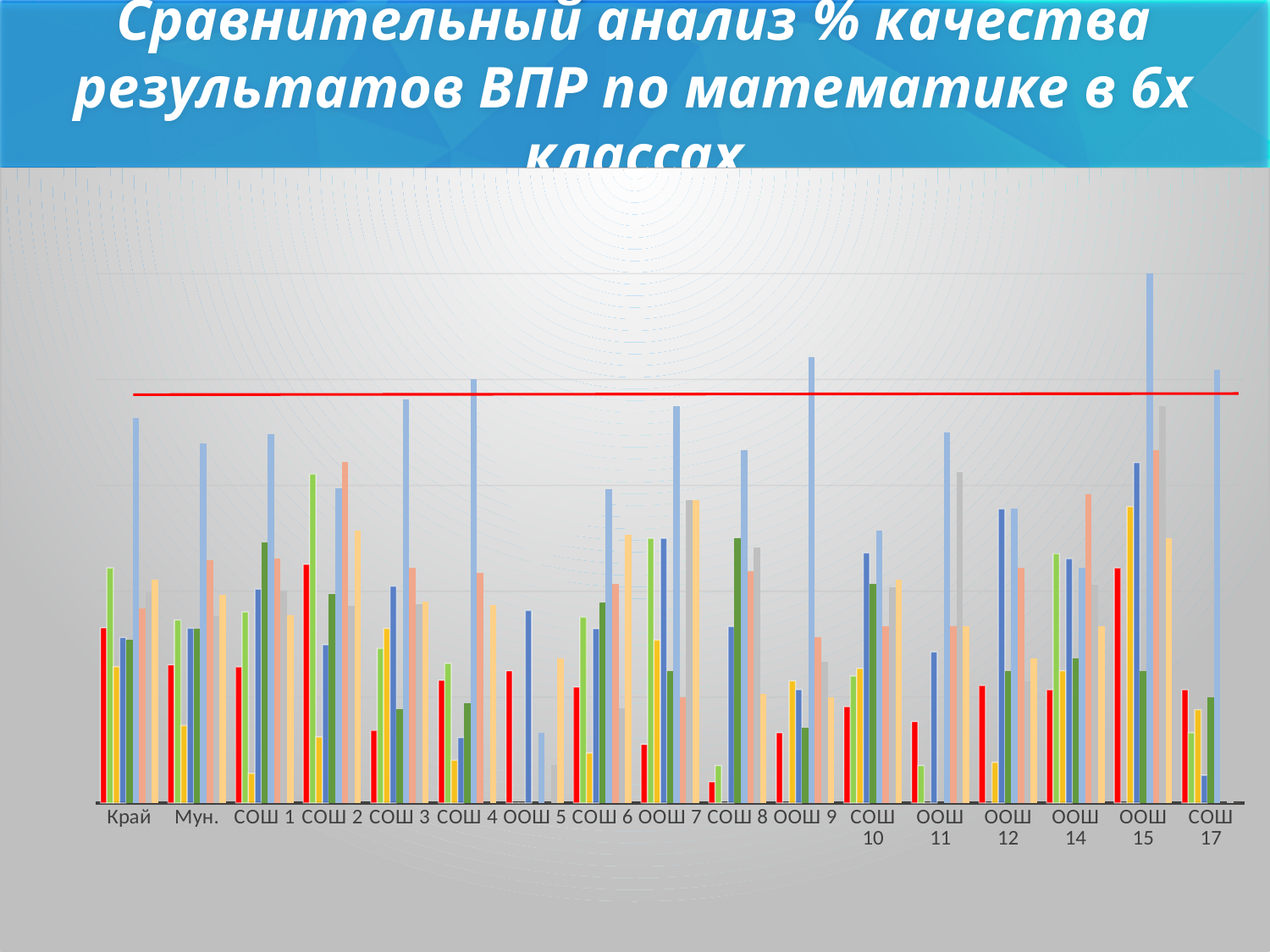
What is the first category on the x axis of the chart? Край How many categories are shown along the x axis of the chart? 17 Which category contains the tallest bar in the chart? ООШ 15 What kind of chart is shown on the slide? bar chart What is the last category on the x axis of the chart? СОШ 17